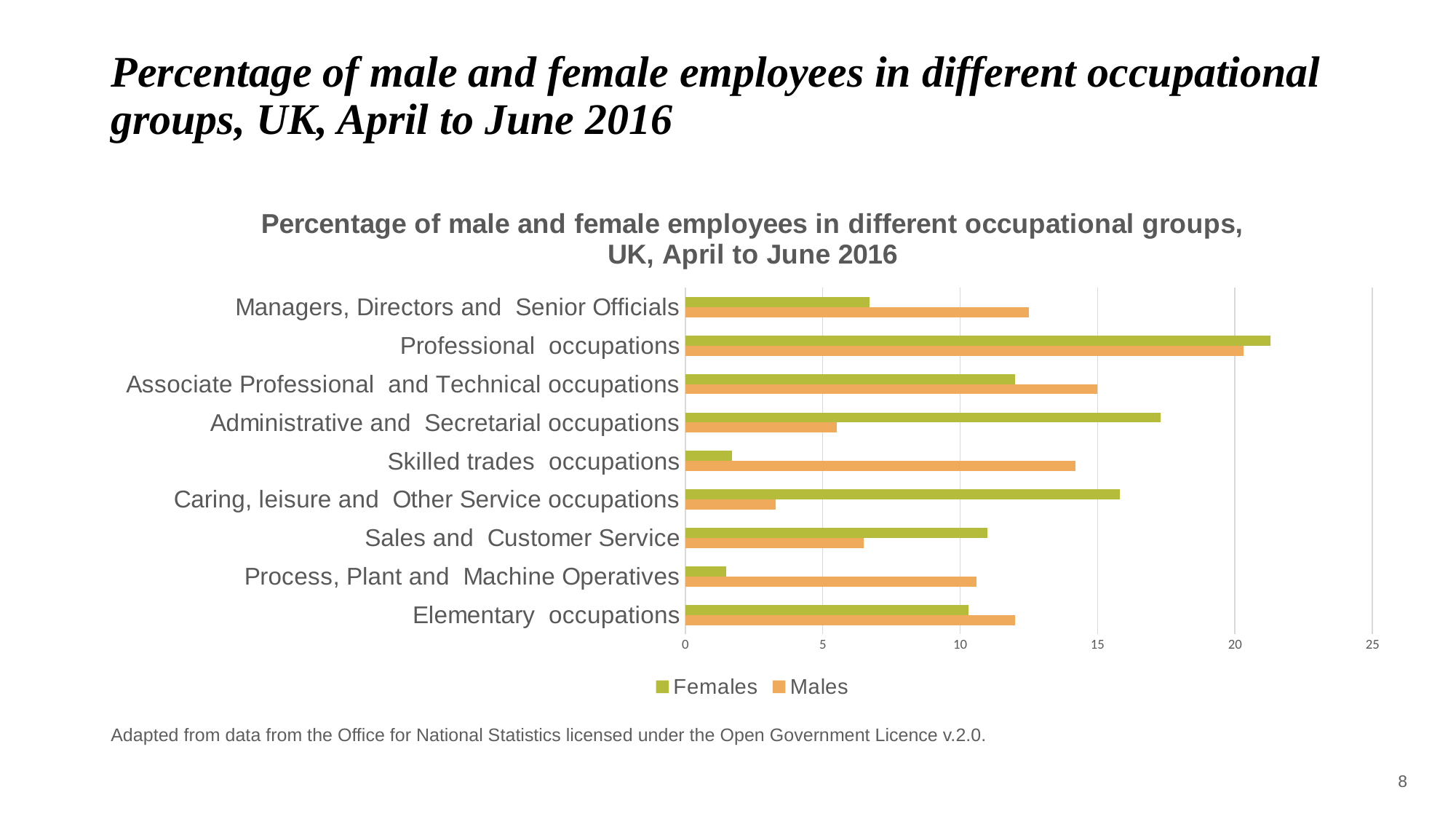
Is the Females value for Managers, Directors and Senior Officials greater or less than 10? less Which occupational group has the highest value for Females? Professional occupations Which occupational group has the highest value for Males? Professional occupations Which occupational group has the lowest value for Males? Caring, leisure and Other Service occupations How many series does the legend list? 2 Which colour represents Males in the chart? orange What kind of chart is shown on the slide? bar chart How many occupational groups are shown on the chart? 9 Is the Males value for Skilled trades occupations greater or less than 10? greater For Administrative and Secretarial occupations, which is larger, the Females value or the Males value? Females For Managers, Directors and Senior Officials, which is larger, the Females value or the Males value? Males Is the Females value for Administrative and Secretarial occupations greater or less than 15? greater